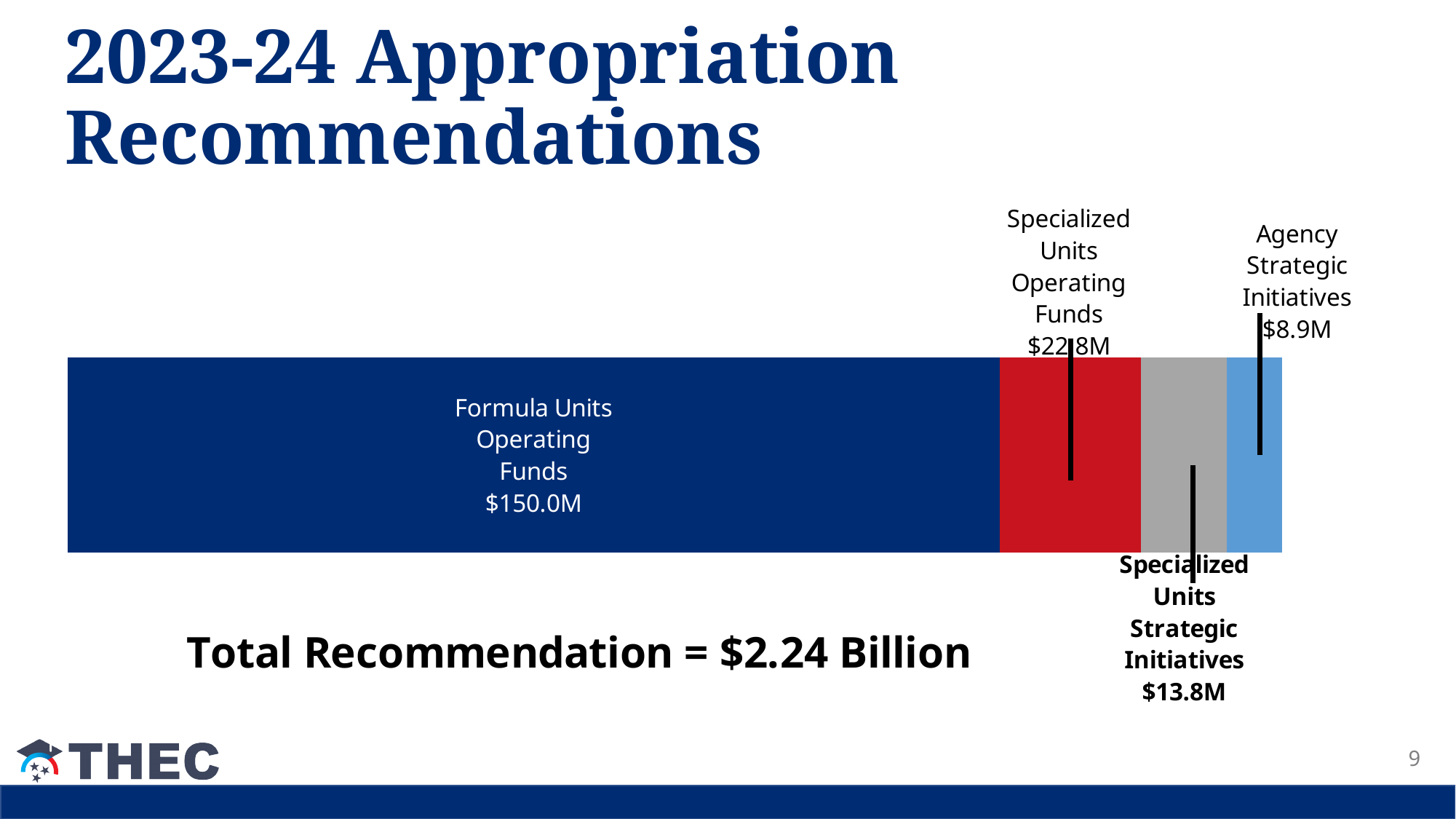
Which is larger, Specialized Units Operating Funds or Specialized Units Strategic Initiatives? Specialized Units Operating Funds What is the difference between Specialized Units Strategic Initiatives and Agency Strategic Initiatives? $4.9M How many segments make up the stacked bar? 4 What is the difference between Formula Units Operating Funds and Specialized Units Strategic Initiatives? $136.2M What kind of chart is shown on the slide? Stacked bar chart What is the value shown for Specialized Units Strategic Initiatives? $13.8M Which segment of the bar has the smallest value? Agency Strategic Initiatives What is the value shown for Formula Units Operating Funds? $150.0M What is the value shown for Agency Strategic Initiatives? $8.9M Which segment of the bar has the largest value? Formula Units Operating Funds Which is larger, Formula Units Operating Funds or Agency Strategic Initiatives? Formula Units Operating Funds What total recommendation amount is stated below the chart? $2.24 Billion